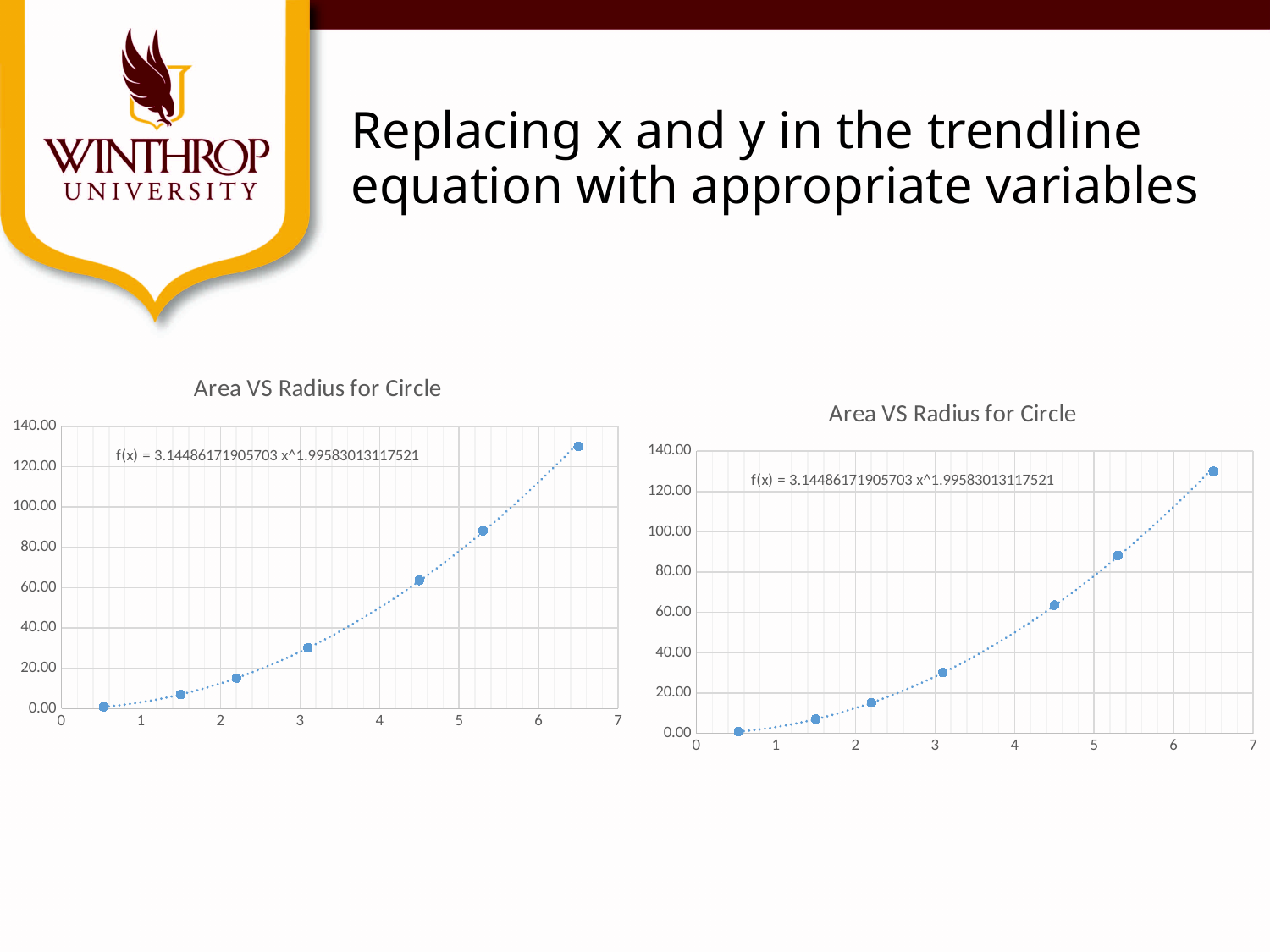
In the left chart, is the value of the rightmost point (near x = 6.5) greater or less than 120? greater In the left chart, do the values rise or fall as the x value increases? rise In the right chart, how many data points are plotted? 7 In the right chart, is the value of the point near x = 3 greater or less than 40? less In the right chart, is the value of the point near x = 4.5 greater or less than 80? less In the right chart, do the values rise or fall as the x value increases? rise In the left chart, which point has the highest value: the one near x = 6.5 or the one near x = 5.3? the one near x = 6.5 What is the title of the right chart? Area VS Radius for Circle In the left chart, how many data points are plotted? 7 What kind of chart is the left chart on the slide? scatter chart What trendline equation is shown on the right chart? f(x) = 3.14486171905703 x^1.99583013117521